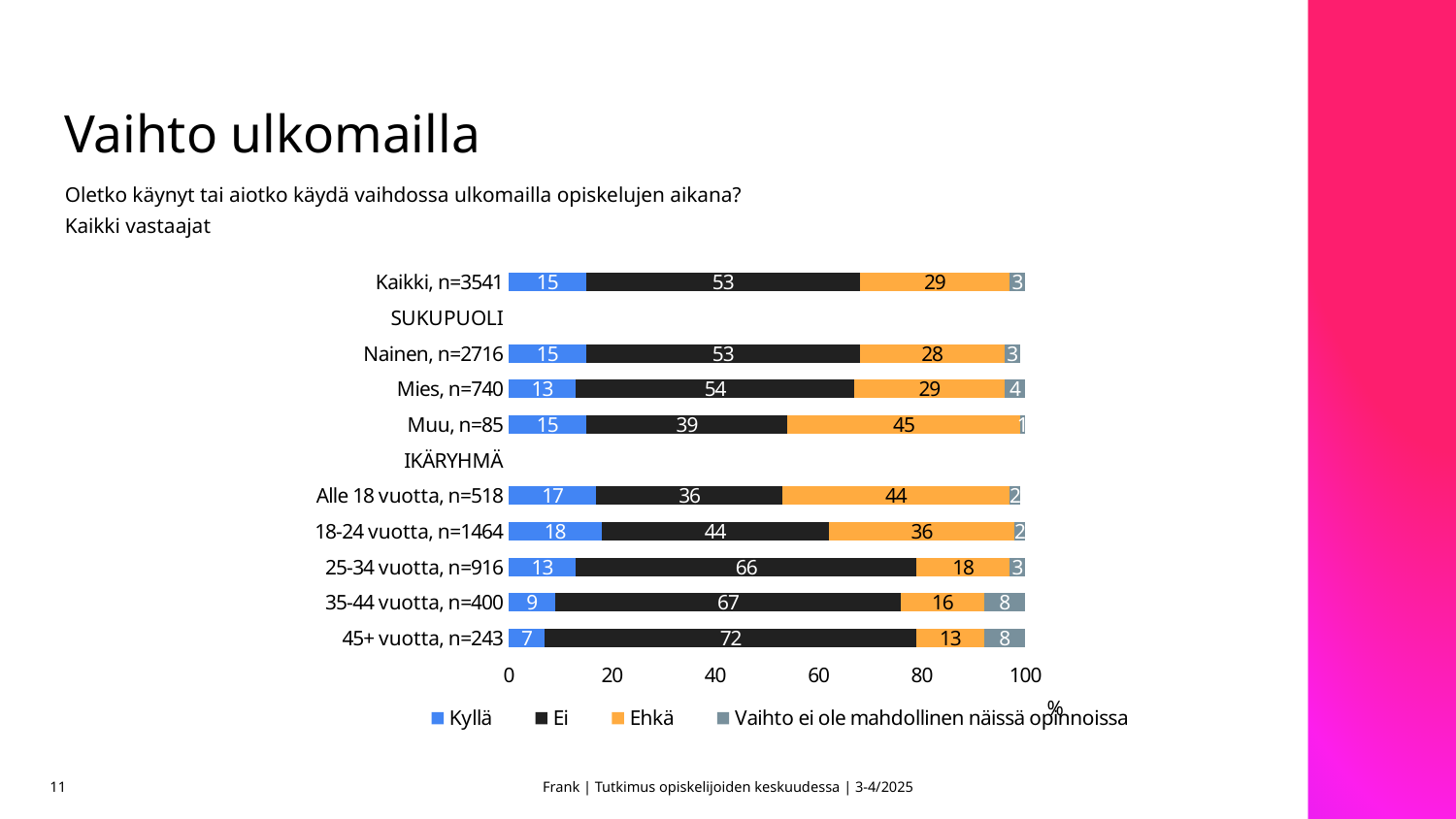
What is the Kyllä value for Kaikki, n=3541? 15 How many series does the legend list? 4 How many bars (categories with data) are plotted in the chart? 9 What is the value of 'Vaihto ei ole mahdollinen näissä opinnoissa' for 35-44 vuotta, n=400? 8 What is the Ei value for 45+ vuotta, n=243? 72 Which category has the highest Ei value? 45+ vuotta, n=243 What is the difference between the Ei values for 25-34 vuotta, n=916 and 18-24 vuotta, n=1464? 22 What kind of chart is shown on the slide? Stacked bar chart Which category has the lowest Kyllä value? 45+ vuotta, n=243 What is the total of the stacked bar for Mies, n=740? 100 What is the Ehkä value for Muu, n=85? 45 Which is larger: the Ehkä value for Alle 18 vuotta, n=518 or for 25-34 vuotta, n=916? Alle 18 vuotta, n=518